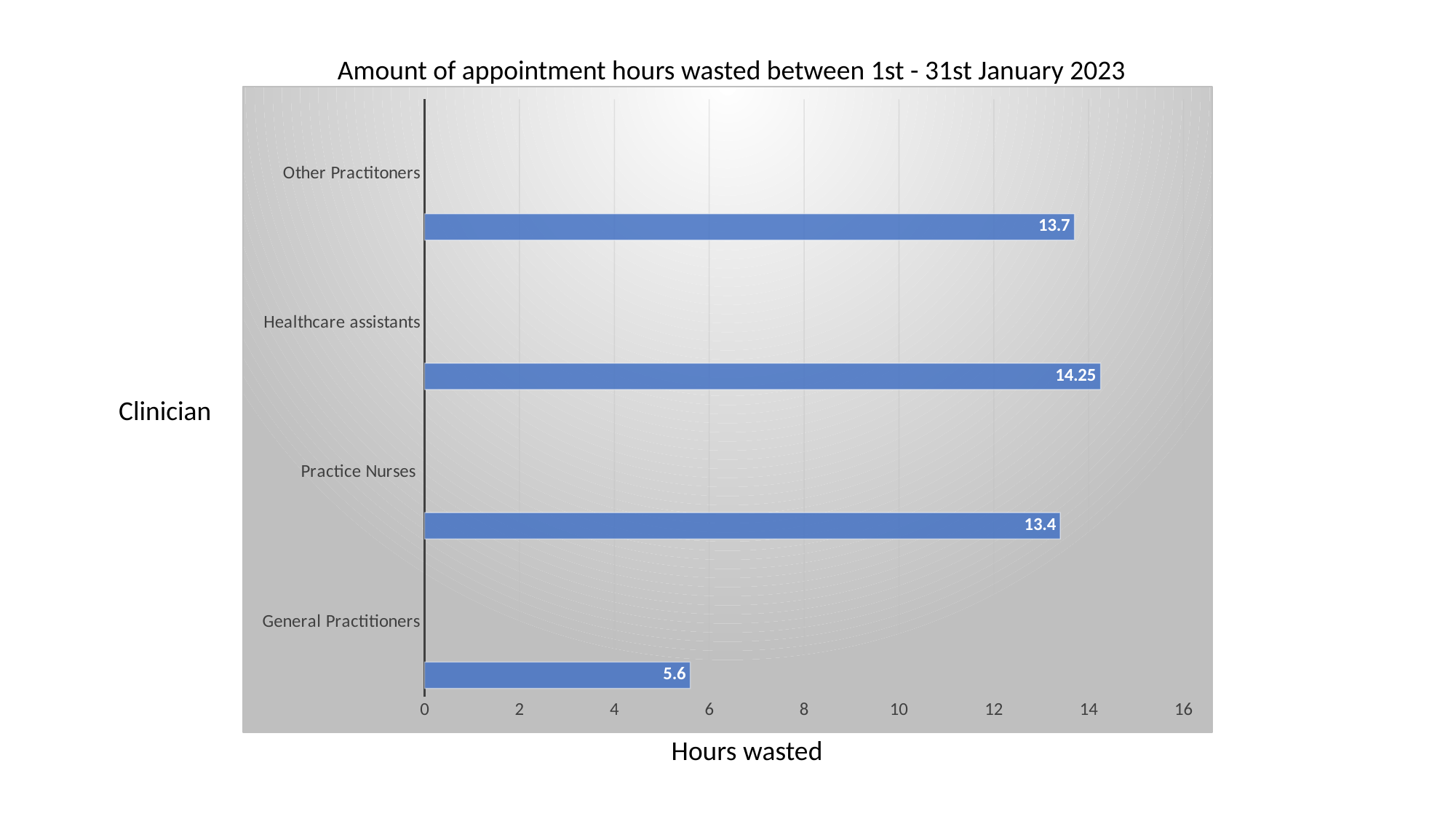
What is the difference in hours wasted between Healthcare assistants and General Practitioners? 8.65 What is the title of the chart? Amount of appointment hours wasted between 1st - 31st January 2023 How many clinician categories are shown in the chart? 4 What type of chart is shown on the slide? Bar chart How many hours were wasted by Healthcare assistants? 14.25 Which wasted more hours, Practice Nurses or General Practitioners? Practice Nurses Which clinician group wasted the fewest appointment hours? General Practitioners How many hours were wasted by Practice Nurses? 13.4 Which clinician group wasted the most appointment hours? Healthcare assistants How many hours were wasted by General Practitioners? 5.6 What is the difference in hours wasted between Other Practitioners and Practice Nurses? 0.3 How many hours were wasted by Other Practitioners? 13.7